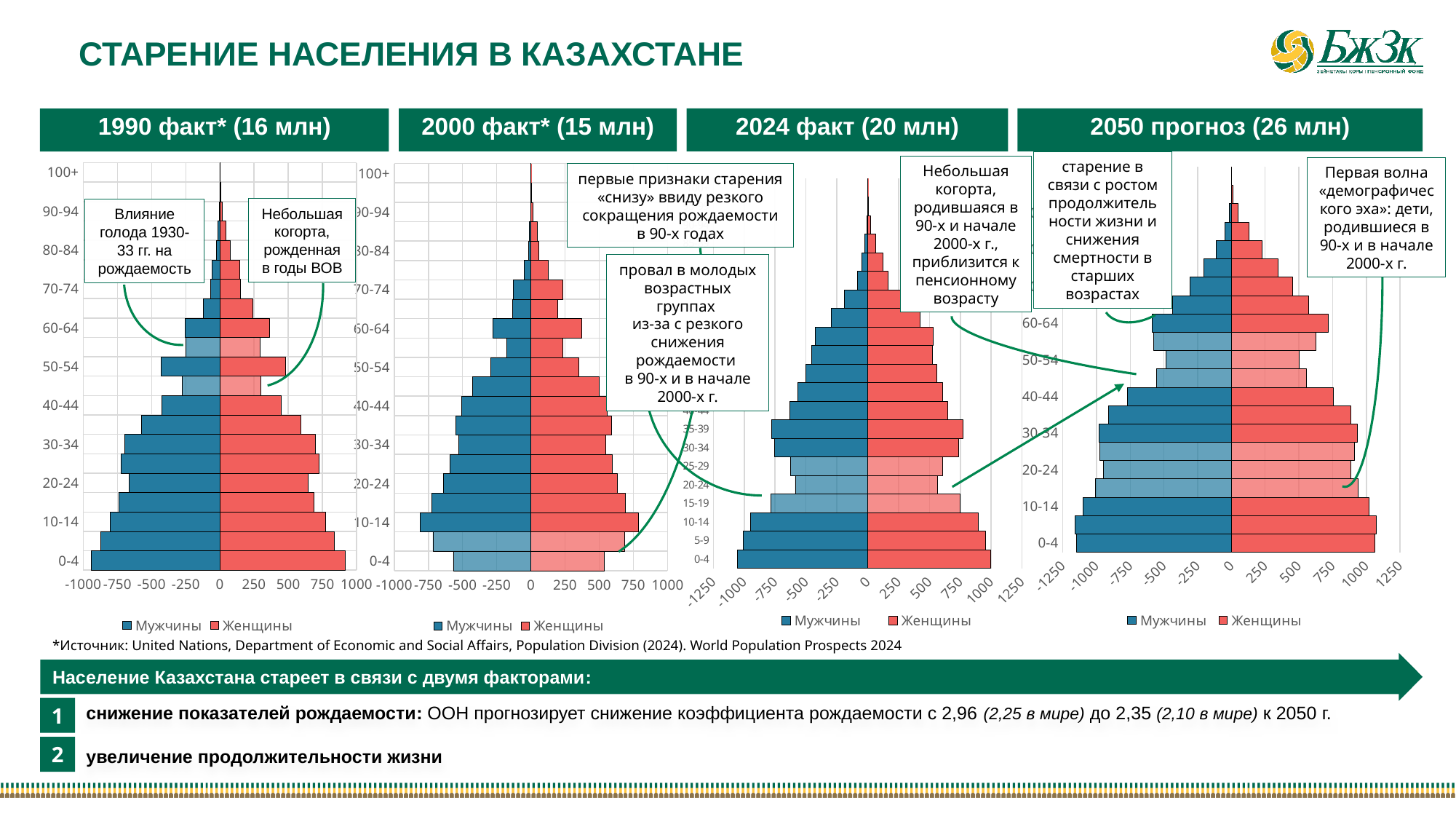
What are the two legend entries of the "2050 прогноз (26 млн)" chart? Мужчины, Женщины How many series does the legend of the "2024 факт (20 млн)" chart list? 2 In the "2000 факт* (15 млн)" chart, is the value for Женщины in the 0-4 age group greater or less than 750? less In the "2000 факт* (15 млн)" chart, which age group has the longest bars? 10-14 How many population pyramid charts are shown on the slide? 4 In the "2024 факт (20 млн)" chart, is the value for Женщины in the 80-84 age group greater or less than 250? less In the "1990 факт* (16 млн)" chart, do the bar lengths generally increase or decrease from the youngest age group to the oldest? decrease In the "2024 факт (20 млн)" chart, is the value for Женщины in the 0-4 age group greater or less than 750? greater What kind of chart is the "1990 факт* (16 млн)" chart? bar chart